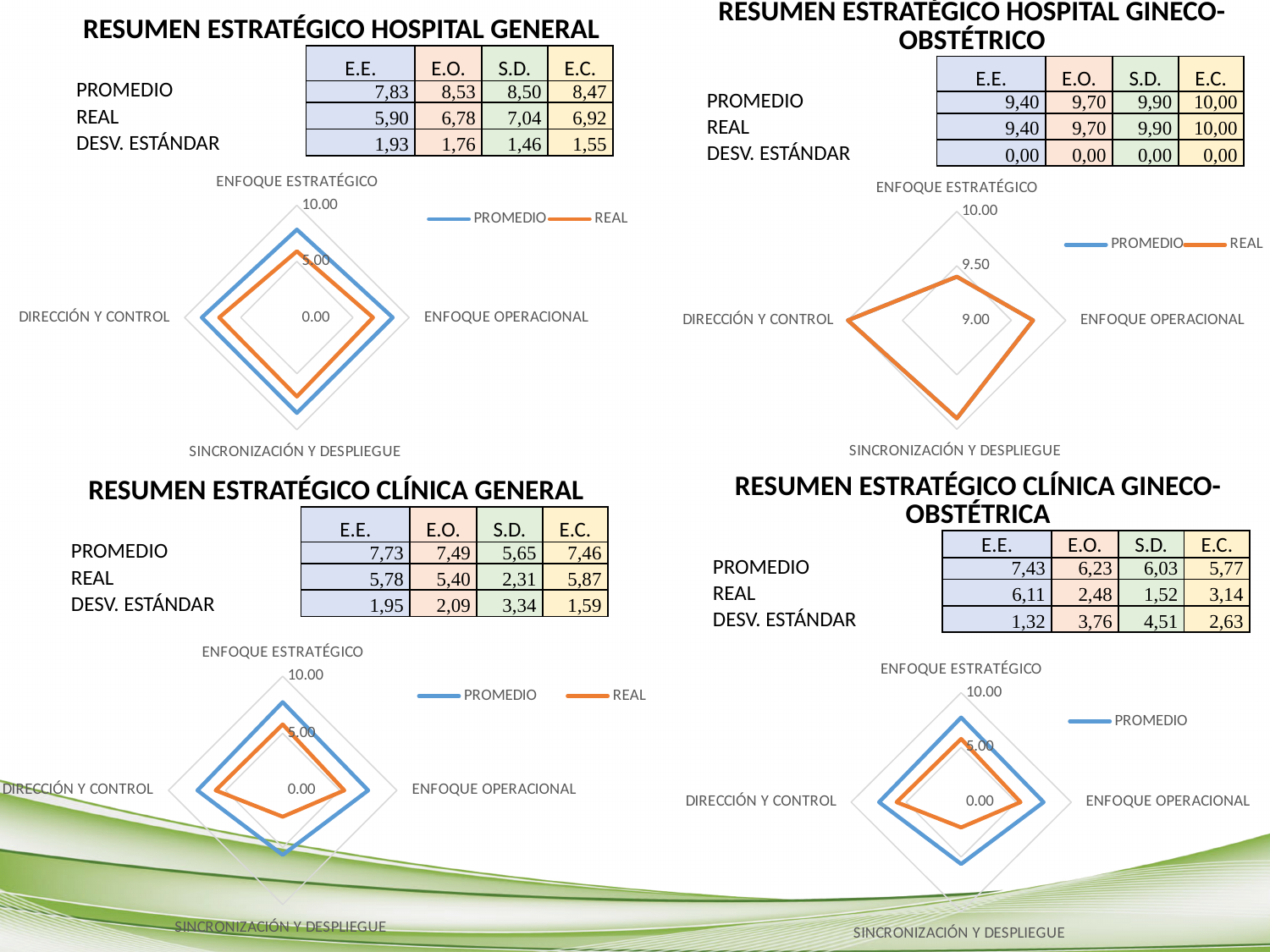
How many series does the legend of the RESUMEN ESTRATÉGICO CLÍNICA GINECO-OBSTÉTRICA radar chart list? 1 How many series does the legend of the RESUMEN ESTRATÉGICO HOSPITAL GENERAL radar chart list? 2 In the RESUMEN ESTRATÉGICO HOSPITAL GENERAL radar chart, is the REAL value for ENFOQUE ESTRATÉGICO greater or less than 5.00? greater In the RESUMEN ESTRATÉGICO HOSPITAL GENERAL section, what is the PROMEDIO value for E.E.? 7,83 In the RESUMEN ESTRATÉGICO CLÍNICA GINECO-OBSTÉTRICA section, which REAL value is larger: E.E. or E.O.? E.E. In the RESUMEN ESTRATÉGICO CLÍNICA GENERAL section, which category has the highest PROMEDIO value? E.E. In the RESUMEN ESTRATÉGICO HOSPITAL GENERAL section, what is the difference between the PROMEDIO and REAL values for E.E.? 1,93 What type of chart is used in the RESUMEN ESTRATÉGICO HOSPITAL GENERAL section? Radar chart In the RESUMEN ESTRATÉGICO CLÍNICA GENERAL section, which category has the lowest REAL value? S.D. How many axes (categories) does the radar chart under RESUMEN ESTRATÉGICO CLÍNICA GENERAL have? 4 What value is shown at the centre of the radar chart under RESUMEN ESTRATÉGICO HOSPITAL GINECO-OBSTÉTRICO? 9.00 In the RESUMEN ESTRATÉGICO HOSPITAL GINECO-OBSTÉTRICO section, what is the REAL value for E.C.? 10,00